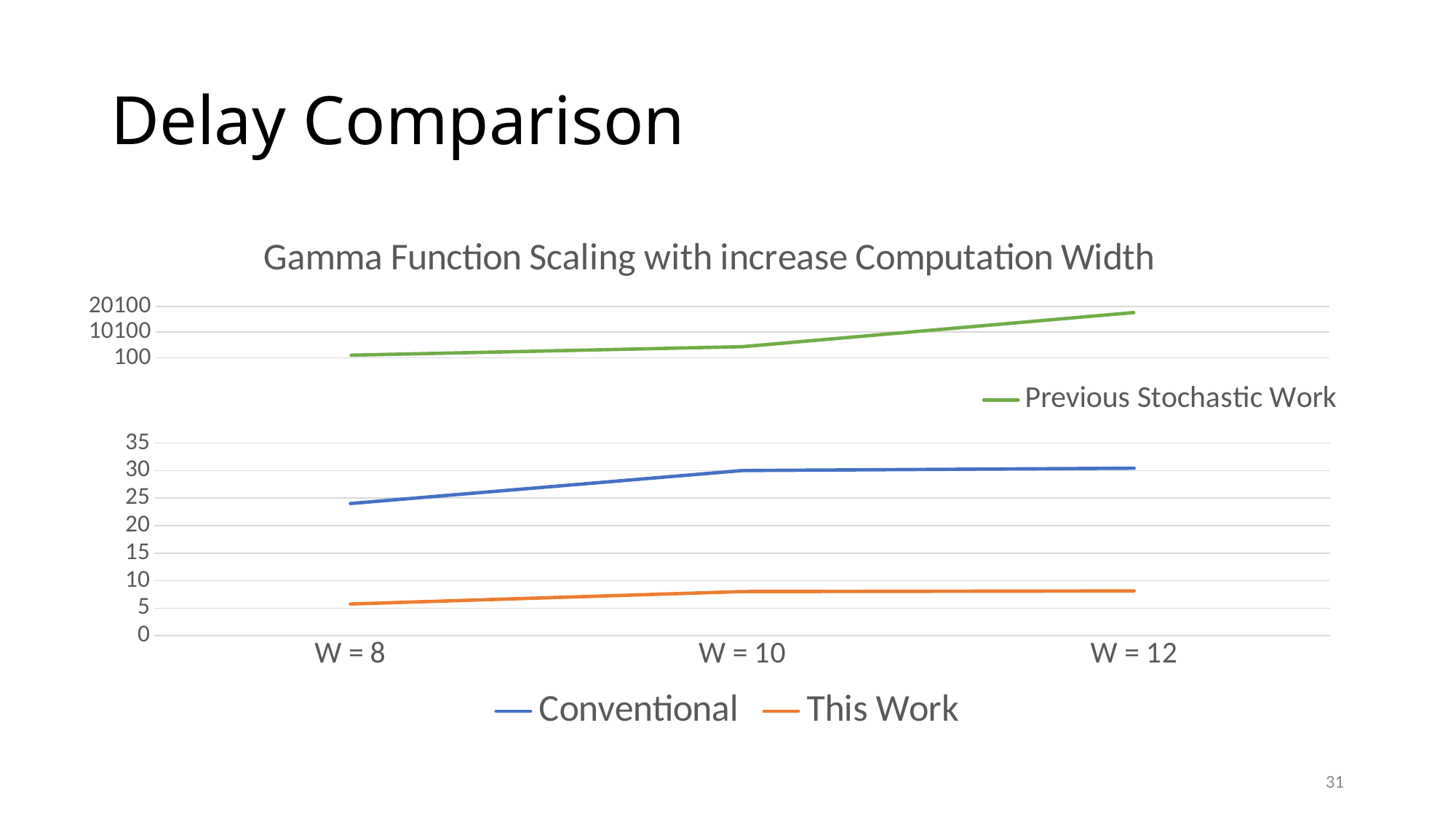
Which series has the lowest value at W = 8? This Work Is the value for Conventional at W = 10 greater or less than 25? greater How many computation width categories are shown on the x axis? 3 Is the value for Conventional at W = 8 greater or less than 20? greater How many series are plotted in the chart? 3 Is the value for This Work at W = 8 greater or less than 10? less Does the Previous Stochastic Work line rise or fall from W = 8 to W = 12? rise What kind of chart is shown on the slide? line chart What is the title of the chart? Gamma Function Scaling with increase Computation Width At W = 10, which is larger: Conventional or This Work? Conventional Which series has the highest value at W = 12? Previous Stochastic Work